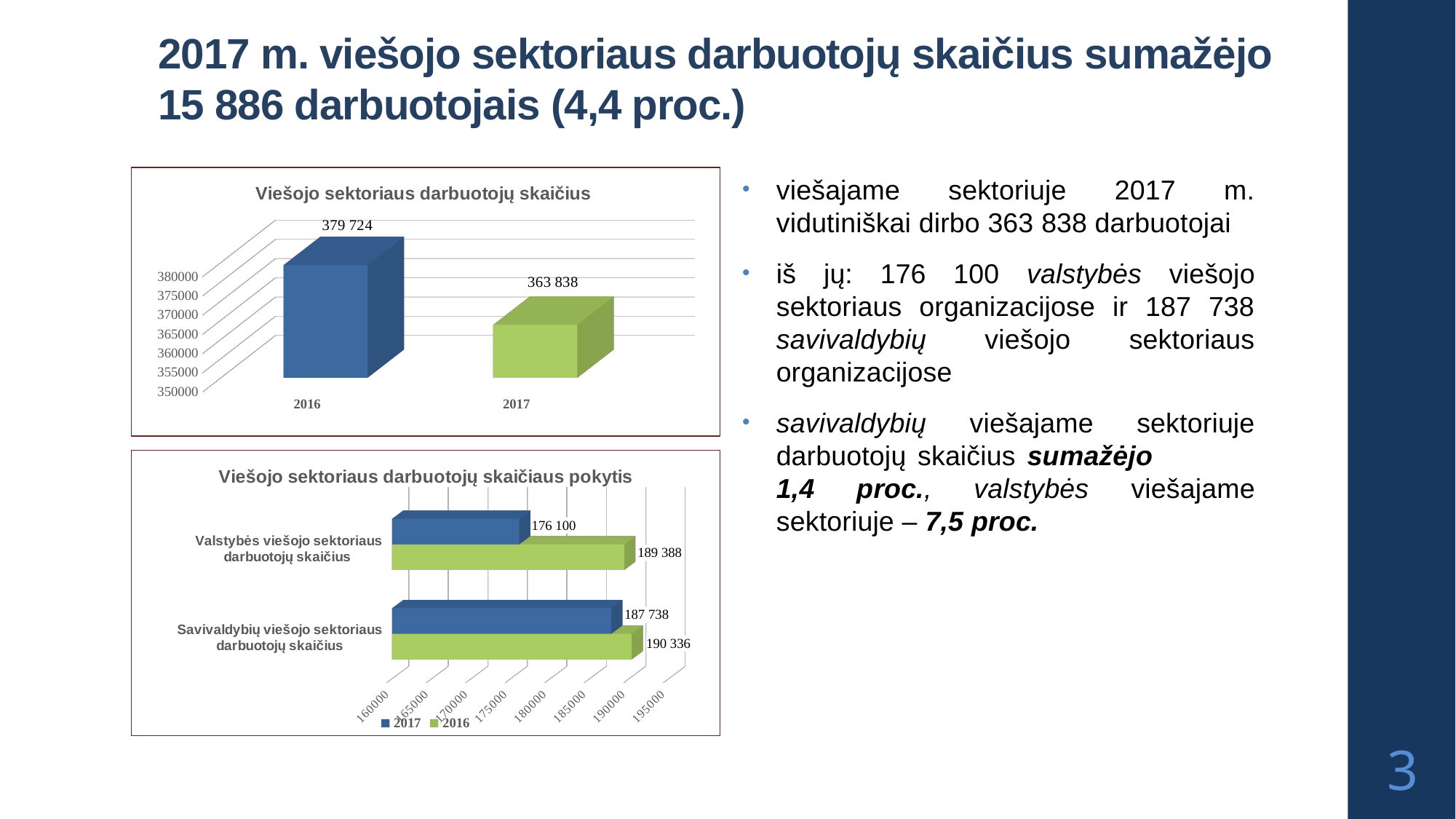
How many series does the legend of the chart titled 'Viešojo sektoriaus darbuotojų skaičiaus pokytis' list? 2 In the chart titled 'Viešojo sektoriaus darbuotojų skaičius', what is the difference between the 2016 and 2017 values? 15 886 In the chart titled 'Viešojo sektoriaus darbuotojų skaičius', do the values rise or fall from 2016 to 2017? fall In the chart titled 'Viešojo sektoriaus darbuotojų skaičiaus pokytis', which is larger: the 2017 value for 'Savivaldybių viešojo sektoriaus darbuotojų skaičius' or the 2017 value for 'Valstybės viešojo sektoriaus darbuotojų skaičius'? Savivaldybių viešojo sektoriaus darbuotojų skaičius In the chart titled 'Viešojo sektoriaus darbuotojų skaičius', which year has the higher value? 2016 In the chart titled 'Viešojo sektoriaus darbuotojų skaičius', what is the value for 2016? 379 724 What kind of chart is the top chart, 'Viešojo sektoriaus darbuotojų skaičius'? bar chart In the chart titled 'Viešojo sektoriaus darbuotojų skaičiaus pokytis', which colour represents the 2016 series? green In the chart titled 'Viešojo sektoriaus darbuotojų skaičiaus pokytis', what is the difference between the 2016 and 2017 values for 'Valstybės viešojo sektoriaus darbuotojų skaičius'? 13 288 In the chart titled 'Viešojo sektoriaus darbuotojų skaičius', what is the value for 2017? 363 838 In the chart titled 'Viešojo sektoriaus darbuotojų skaičiaus pokytis', what is the 2016 value for 'Savivaldybių viešojo sektoriaus darbuotojų skaičius'? 190 336 In the chart titled 'Viešojo sektoriaus darbuotojų skaičiaus pokytis', what is the 2017 value for 'Valstybės viešojo sektoriaus darbuotojų skaičius'? 176 100